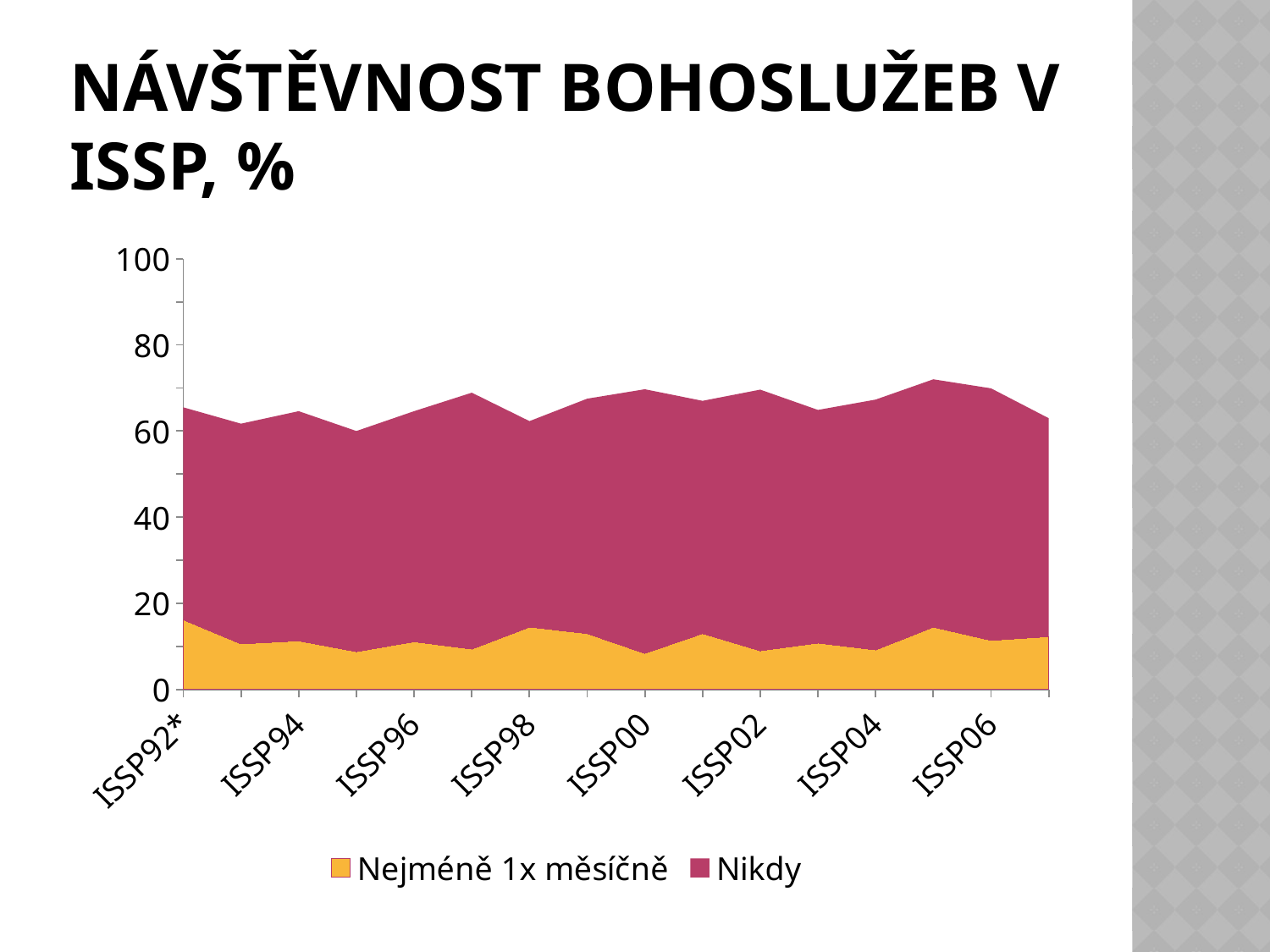
What kind of chart is shown on the slide? area chart Is the value for Nejméně 1x měsíčně at ISSP98 greater or less than 10? greater What are the two series named in the legend? Nejméně 1x měsíčně and Nikdy Is the combined top of the stacked areas at ISSP00 greater or less than 80? less Is the value for Nejméně 1x měsíčně at ISSP92* greater or less than 20? less How many category labels are printed on the x axis? 8 What is the title of the chart? NÁVŠTĚVNOST BOHOSLUŽEB V ISSP, % How many series does the legend list? 2